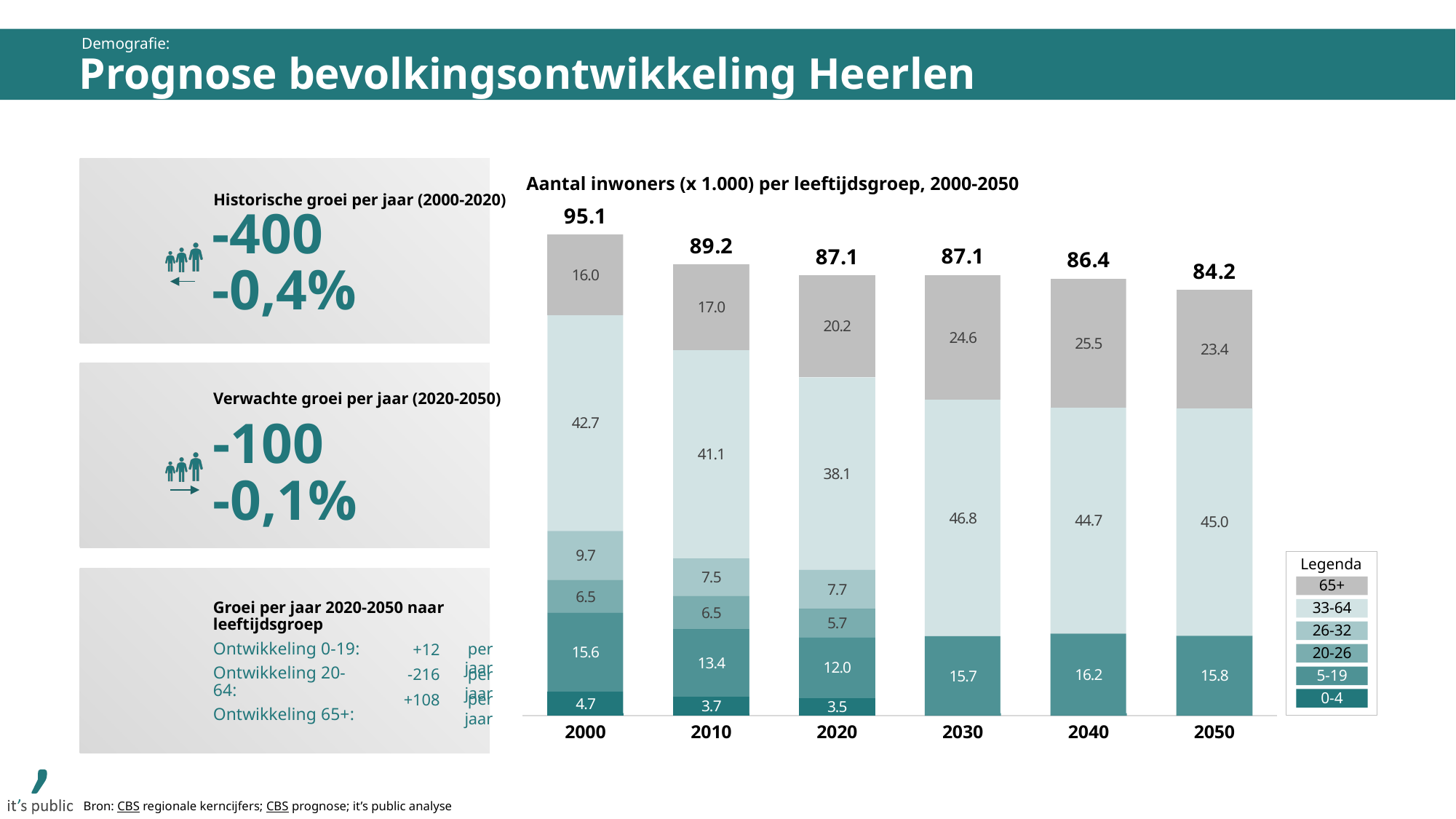
What is the value for the 0-4 age group in 2000? 4.7 What kind of chart is shown on the slide? Stacked bar chart What is the value for the 65+ age group in 2020? 20.2 Which is larger, the 65+ value in 2040 or the 65+ value in 2050? 2040 What is the difference between the total for 2000 and the total for 2050? 10.9 How many years are shown on the x axis of the chart? 6 Do the total values rise or fall from 2000 to 2050? Fall How many age groups does the legend list? 6 What is the total number of inhabitants (x 1.000) shown above the bar for 2000? 95.1 Which year has the lowest total number of inhabitants? 2050 Which year has the highest total number of inhabitants? 2000 What is the value for the 33-64 age group in 2010? 41.1